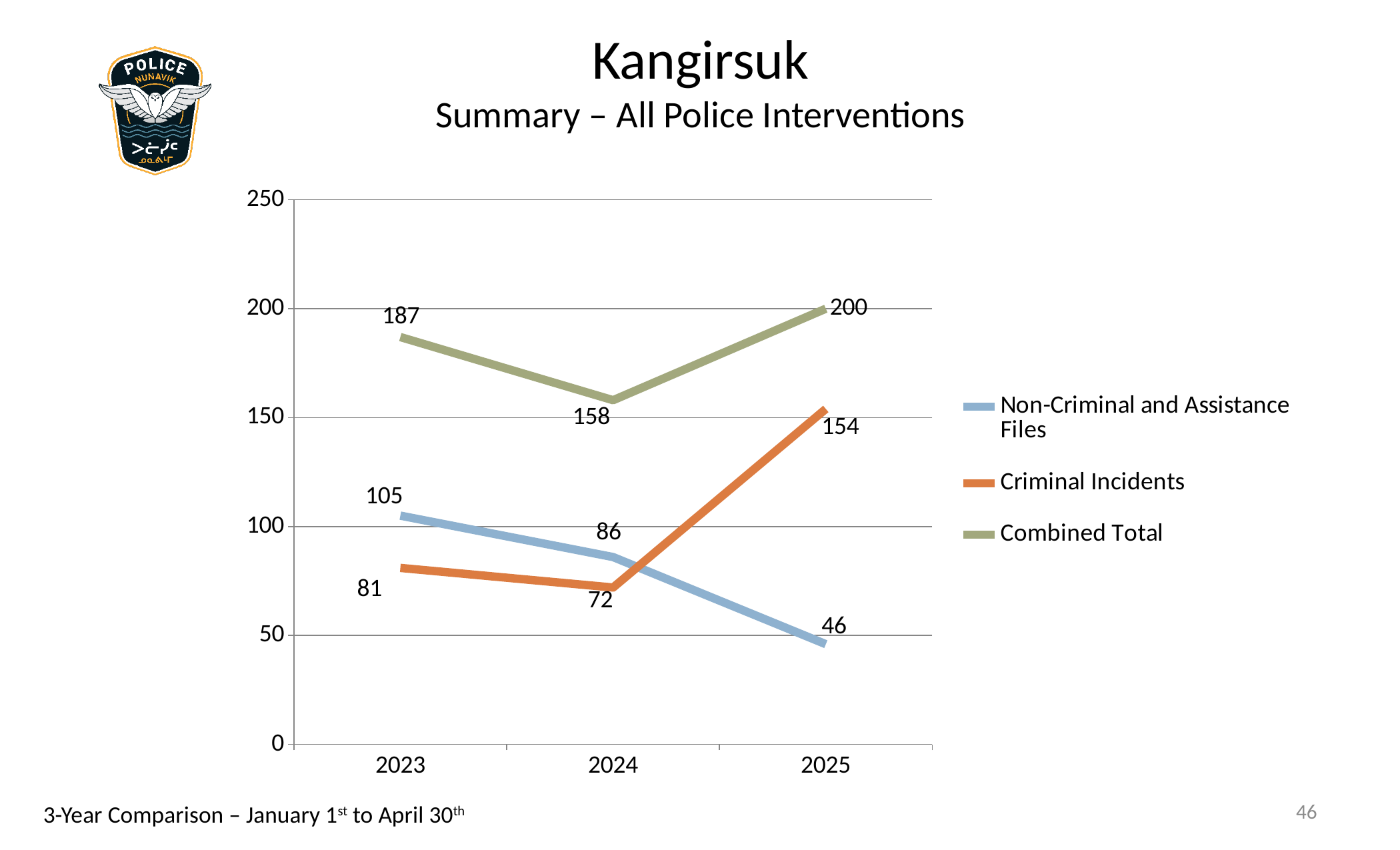
In which year is the value for Non-Criminal and Assistance Files lowest? 2025 Which is larger in 2023: Non-Criminal and Assistance Files or Criminal Incidents? Non-Criminal and Assistance Files Does the value for Non-Criminal and Assistance Files rise or fall from 2023 to 2025? Fall What kind of chart is shown on the slide? Line chart What is the Combined Total for 2024? 158 Is the value for Criminal Incidents in 2025 greater or less than 150? greater What is the value for Non-Criminal and Assistance Files in 2023? 105 How many series does the legend list? 3 What is the difference between Criminal Incidents in 2025 and in 2024? 82 In which year is the Combined Total highest? 2025 What is the value for Criminal Incidents in 2025? 154 How many years are shown on the x axis? 3